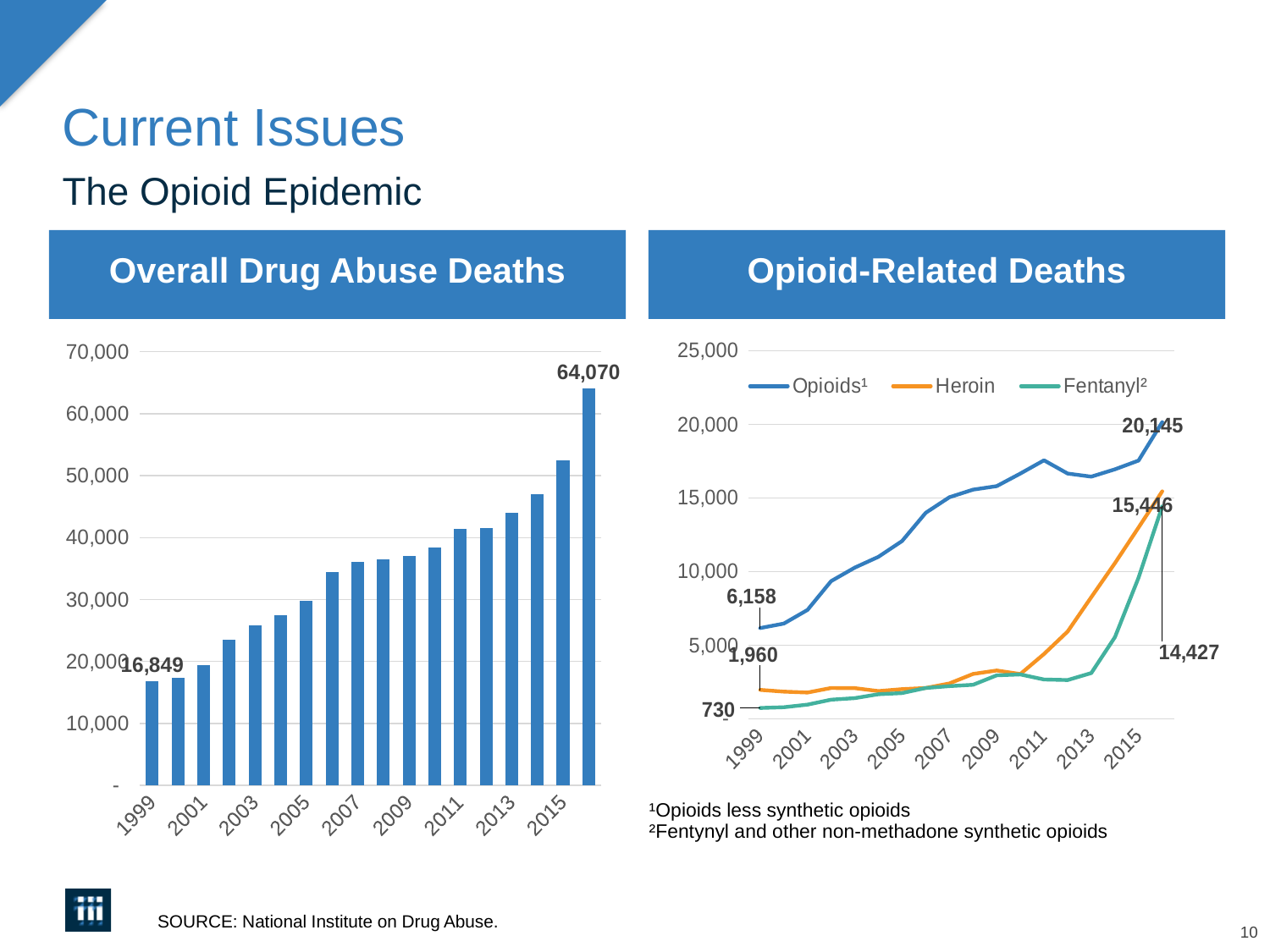
What kind of chart is the Overall Drug Abuse Deaths chart? bar chart In the Overall Drug Abuse Deaths chart, is the value for 2003 greater or less than 30,000? less What kind of chart is the Opioid-Related Deaths chart? line chart In the Opioid-Related Deaths chart, what is the Fentanyl value for 1999? 730 In the Overall Drug Abuse Deaths chart, what is the difference between the 2016 value and the 1999 value? 47,221 In the Opioid-Related Deaths chart, what is the Opioids value for 1999? 6,158 How many series does the legend of the Opioid-Related Deaths chart list? 3 In the Opioid-Related Deaths chart, what is the Heroin value at the end of the series (2016)? 15,446 In the Overall Drug Abuse Deaths chart, what is the value for 1999? 16,849 In the Overall Drug Abuse Deaths chart, do the values generally rise or fall from 1999 to 2016? rise In the Overall Drug Abuse Deaths chart, what is the value for the last year shown (2016)? 64,070 In the Opioid-Related Deaths chart, which is larger at the end of the series (2016): Heroin or Fentanyl? Heroin